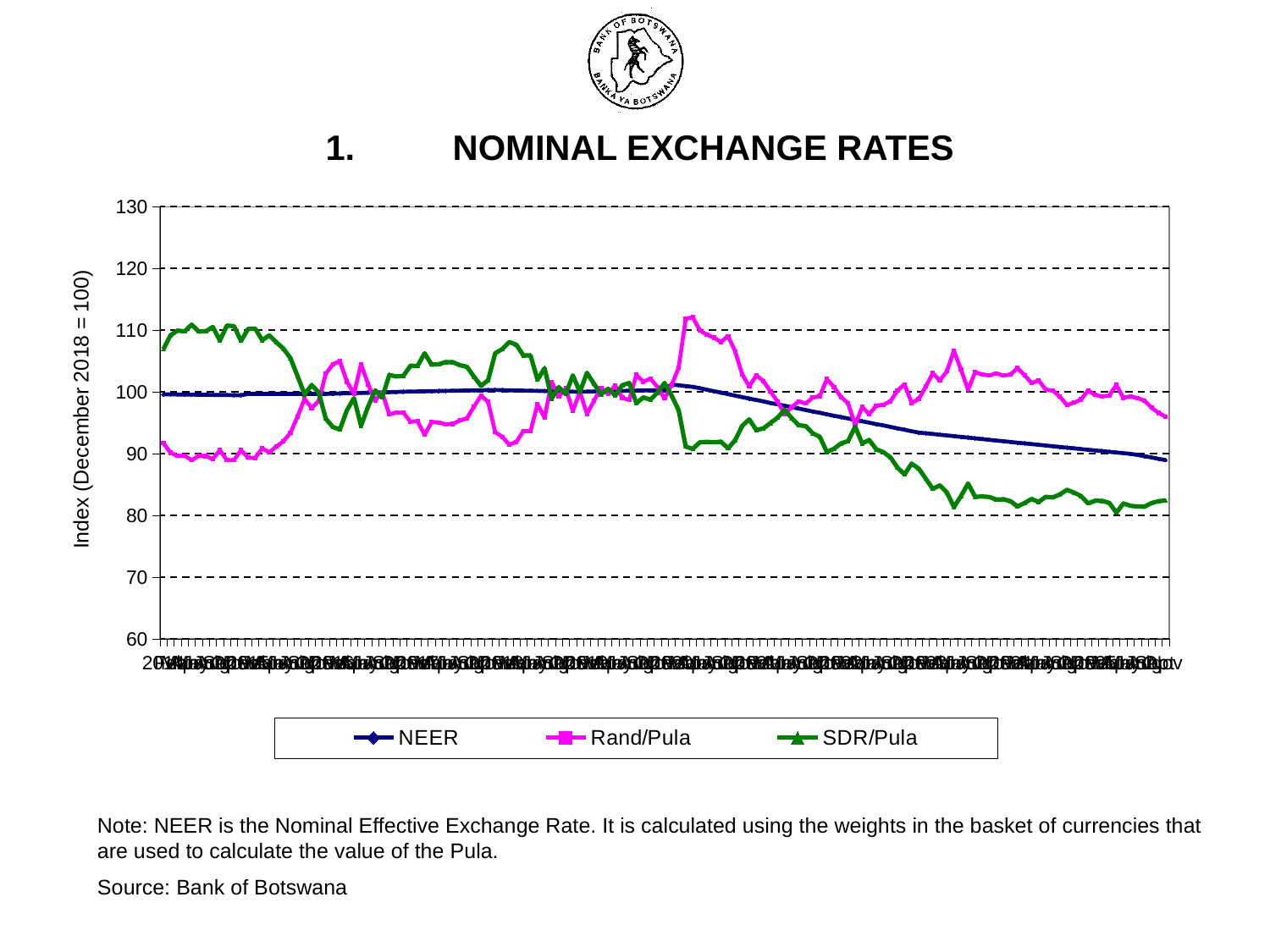
Is the value of SDR/Pula at the left end of the chart greater or less than 100? greater How many series does the legend list? 3 Is the value of NEER at the right end of the chart greater or less than 100? less What kind of chart is shown on the slide? Line chart Is the value of SDR/Pula at the right end of the chart greater or less than 90? less What is the title of the chart? NOMINAL EXCHANGE RATES Does the NEER series rise or fall overall from left to right? Fall Does the SDR/Pula series rise or fall overall from left to right? Fall What is the label on the vertical axis? Index (December 2018 = 100) At the right end of the chart, which is higher, Rand/Pula or SDR/Pula? Rand/Pula Which series reaches the lowest value anywhere on the chart? SDR/Pula